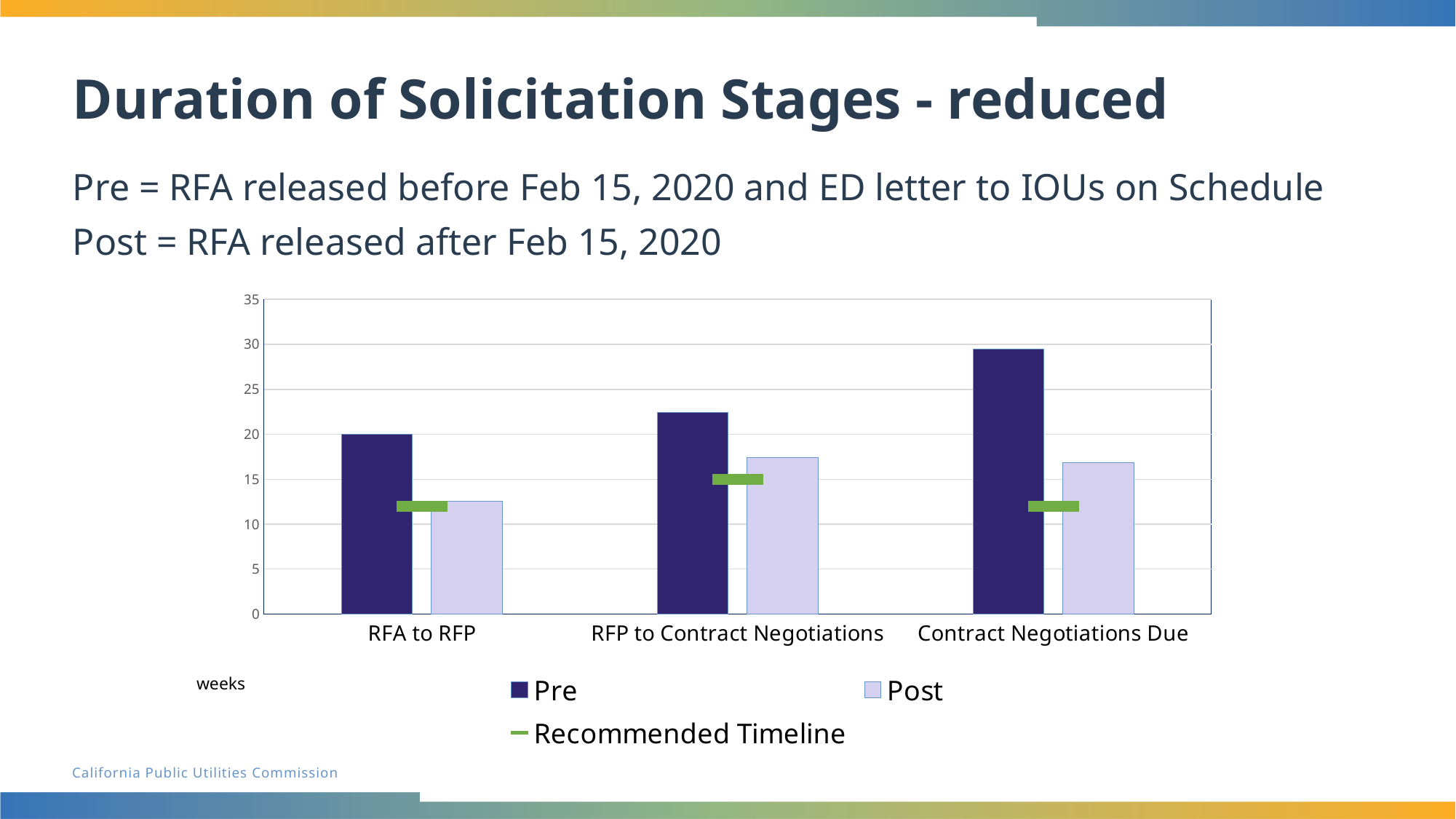
For Contract Negotiations Due, which is larger, the Pre value or the Post value? Pre How many solicitation stage categories are shown on the x axis? 3 How many series does the legend list? 3 What unit is indicated for the values on the chart? weeks Is the Post value for RFP to Contract Negotiations greater or less than 20? less Is the Post value for RFA to RFP greater or less than 15? less For RFA to RFP, which is larger, the Pre value or the Post value? Pre Which category has the lowest Post value? RFA to RFP Which category has the lowest Pre value? RFA to RFP Which category has the highest Pre value? Contract Negotiations Due What kind of chart is shown on the slide? bar chart Is the Pre value for Contract Negotiations Due greater or less than 25? greater